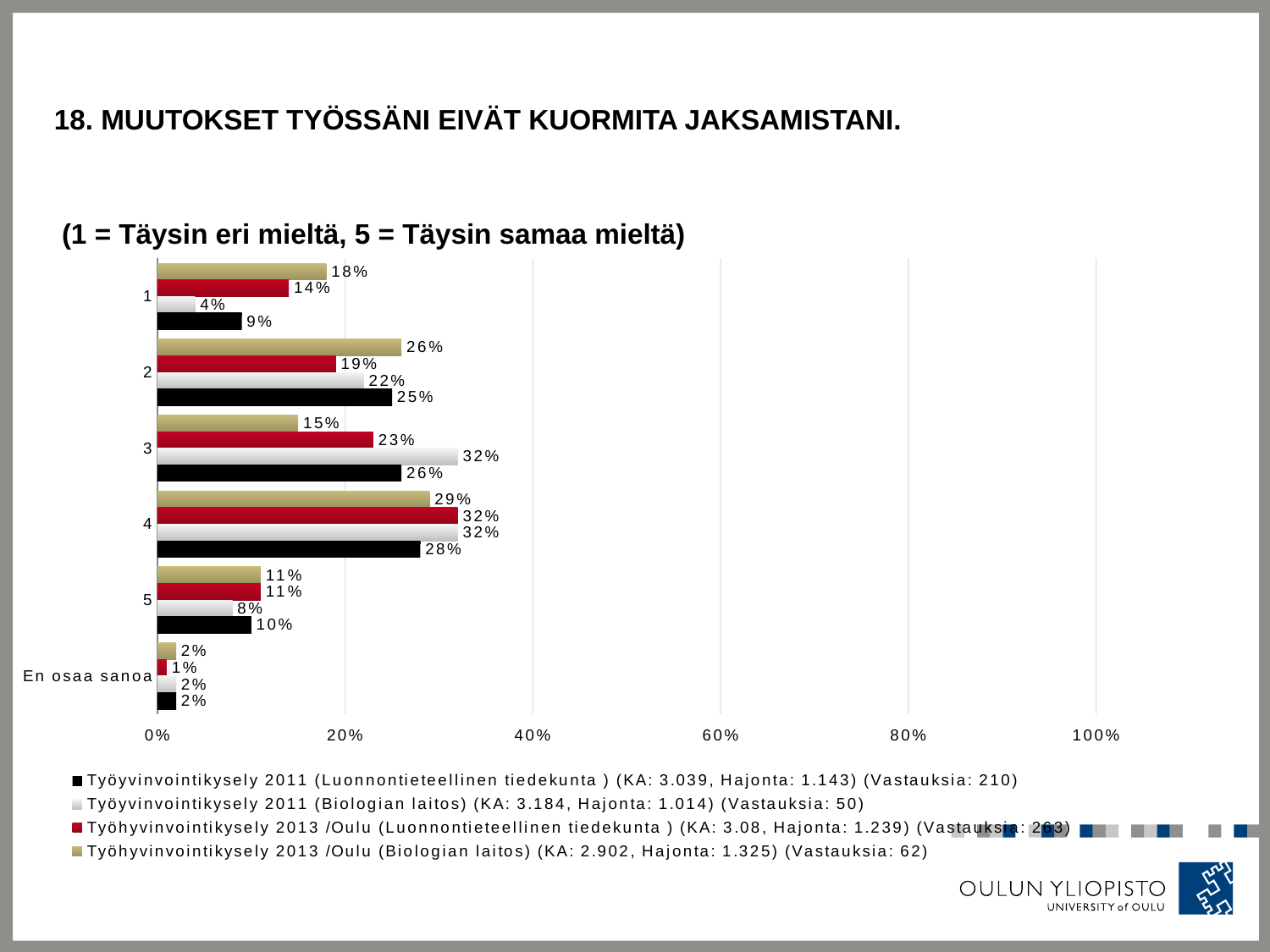
What is the value for category 3 in the Työyvinvointikysely 2011 (Biologian laitos) series? 32% Which category has the lowest value in the Työyvinvointikysely 2011 (Biologian laitos) series? En osaa sanoa What is the value for category 2 in the Työyvinvointikysely 2011 (Luonnontieteellinen tiedekunta) series? 25% How many series does the legend list? 4 What is the value for category 1 in the Työhyvinvointikysely 2013 /Oulu (Biologian laitos) series? 18% For category 1, which is larger: the Työhyvinvointikysely 2013 /Oulu (Luonnontieteellinen tiedekunta) value or the Työyvinvointikysely 2011 (Biologian laitos) value? Työhyvinvointikysely 2013 /Oulu (Luonnontieteellinen tiedekunta) How many categories are shown on the vertical axis? 6 What is the number of responses (Vastauksia) listed in the legend for Työhyvinvointikysely 2013 /Oulu (Luonnontieteellinen tiedekunta)? 263 What is the value for 'En osaa sanoa' in the Työhyvinvointikysely 2013 /Oulu (Luonnontieteellinen tiedekunta) series? 1% Which category has the highest value in the Työhyvinvointikysely 2013 /Oulu (Biologian laitos) series? 4 What is the difference between the Työyvinvointikysely 2011 (Biologian laitos) value and the Työhyvinvointikysely 2013 /Oulu (Biologian laitos) value for category 3? 17% What type of chart is shown on the slide? bar chart